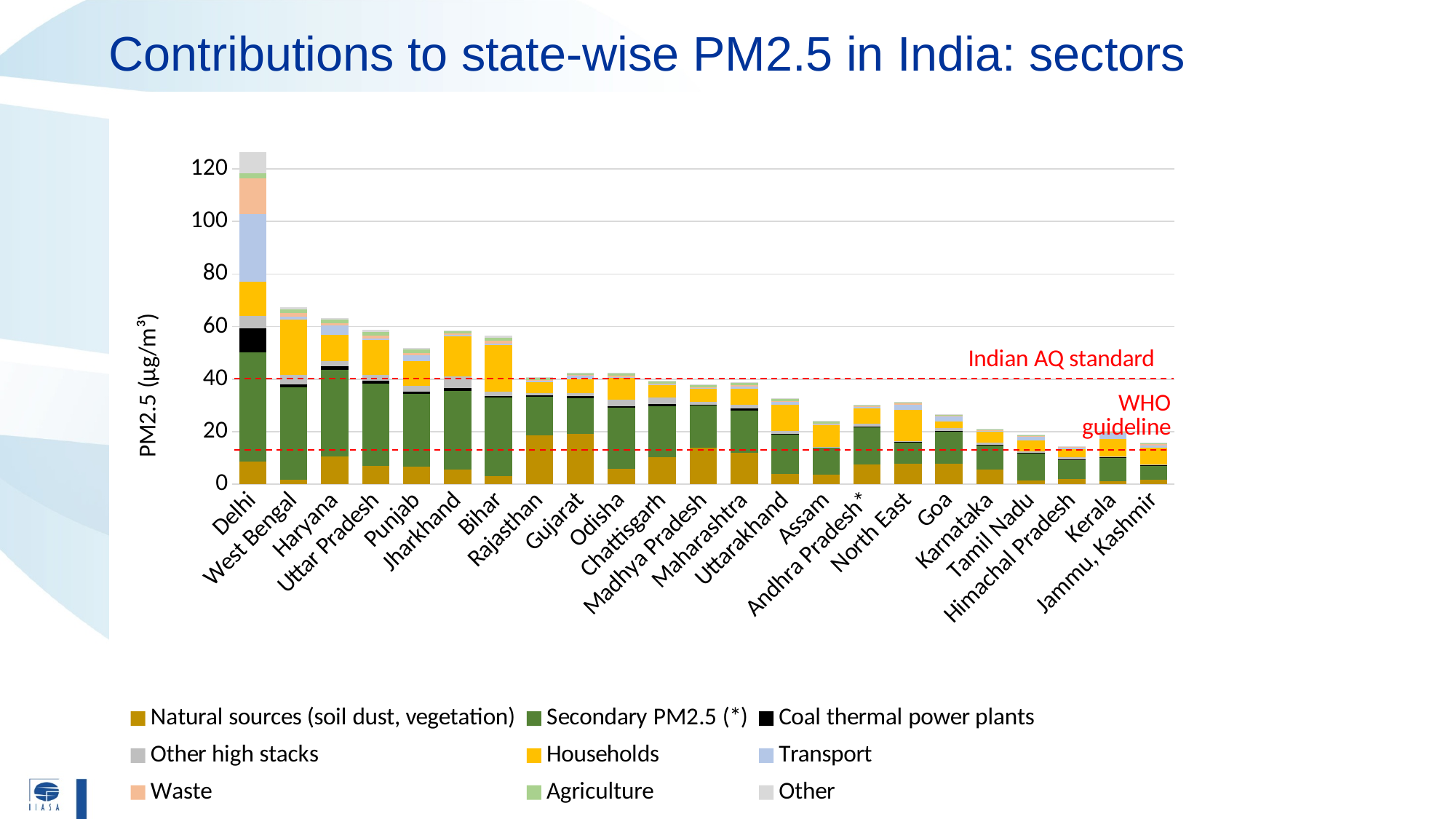
What is the label of the y axis? PM2.5 (µg/m³) How many states or regions are plotted along the x axis? 23 Is the total value for Delhi greater or less than 120? greater Which has a larger total PM2.5 value, Haryana or Goa? Haryana Do the total bar heights generally rise or fall moving from left to right along the x axis? fall Is the total value for West Bengal greater or less than 60? greater Which state has the highest total PM2.5 value? Delhi What kind of chart is shown on the slide? Stacked bar chart What are the two dashed red reference lines labelled? Indian AQ standard and WHO guideline Is the total value for Assam greater or less than 40? less How many series does the legend list? 9